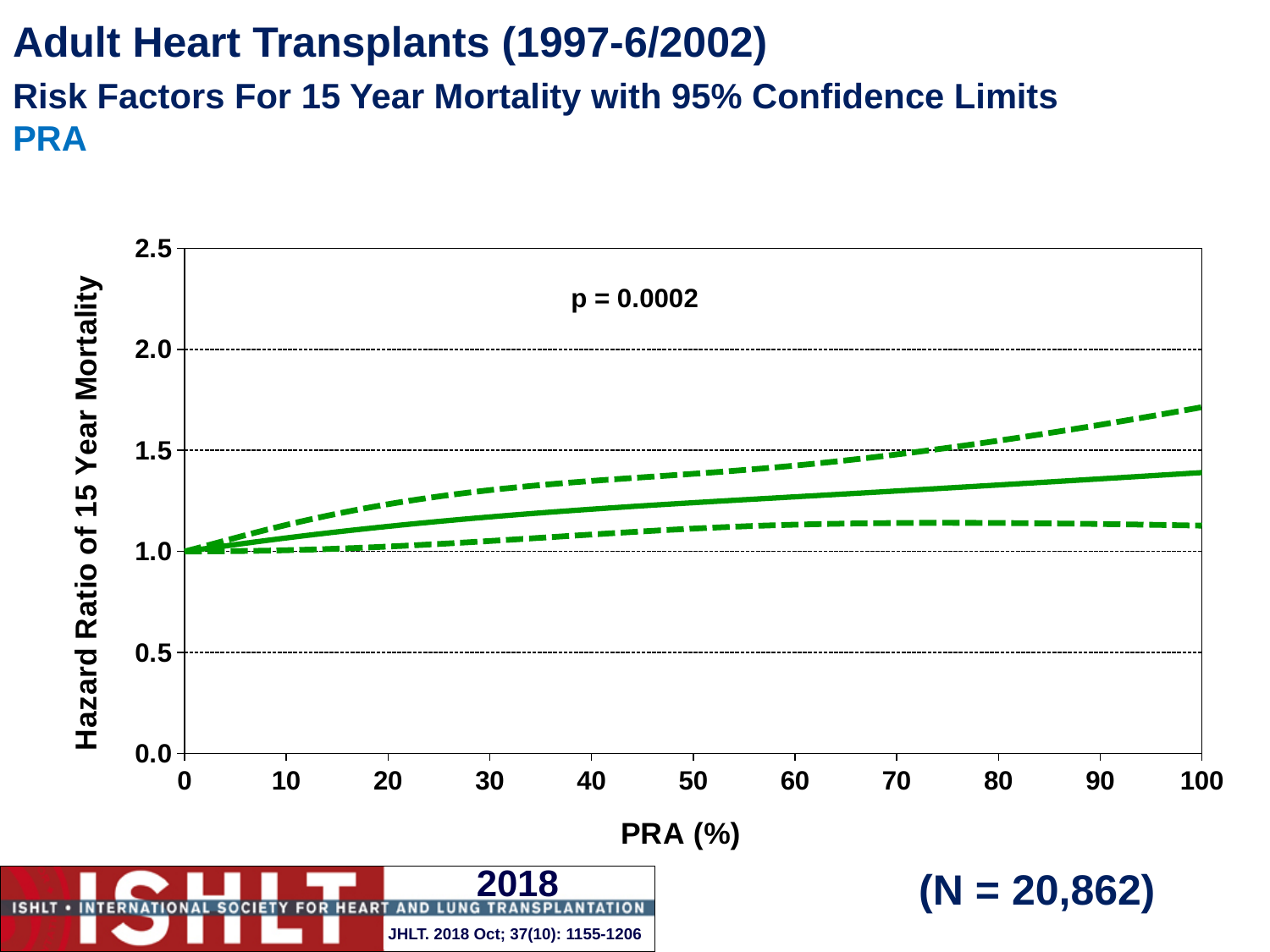
Is the lower 95% confidence limit at a PRA of 100% greater or less than 1.5? less What is the hazard ratio of 15 year mortality at a PRA of 0%? 1.0 What is the label of the x axis? PRA (%) Is the upper 95% confidence limit at a PRA of 100% greater or less than 2.0? less Is the upper 95% confidence limit at a PRA of 100% greater or less than 1.5? greater What p-value is printed on the chart? p = 0.0002 How many lines are plotted on the chart? 3 Does the hazard ratio of 15 year mortality rise or fall as PRA (%) increases? rise What kind of chart is shown on the slide? line chart